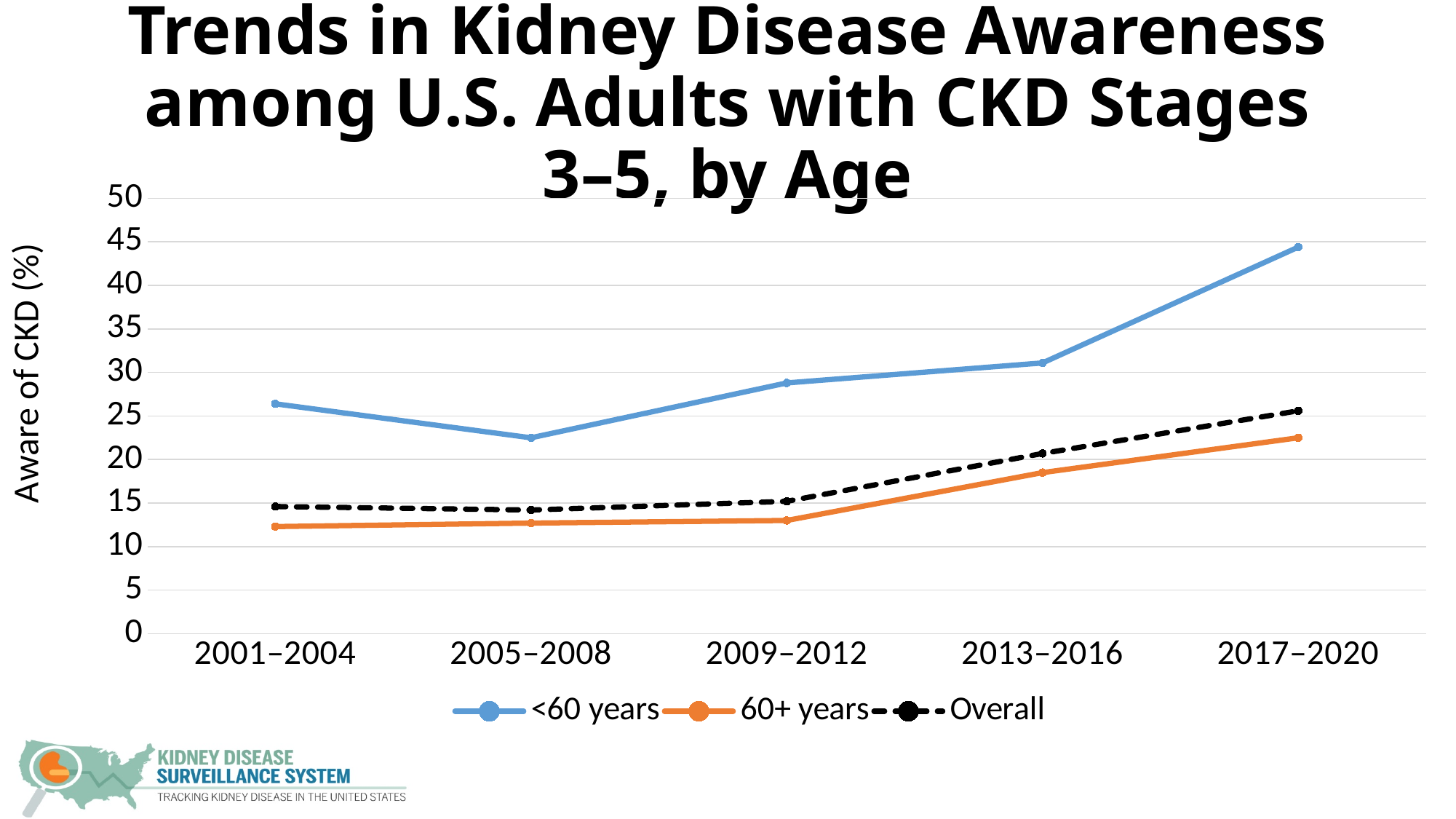
In which period is the <60 years series at its highest? 2017–2020 Is the value for <60 years in 2017–2020 greater or less than 40? greater Does the 60+ years series rise or fall from 2009–2012 to 2017–2020? rise Is the value for Overall in 2017–2020 greater or less than 20? greater Is the value for 60+ years in 2001–2004 greater or less than 15? less In 2017–2020, which is larger: the value for <60 years or for 60+ years? <60 years How many series does the legend list? 3 What kind of chart is shown on the slide? line chart What is the label on the y axis? Aware of CKD (%) How many time periods are shown on the x axis? 5 In which period is the <60 years series at its lowest? 2005–2008